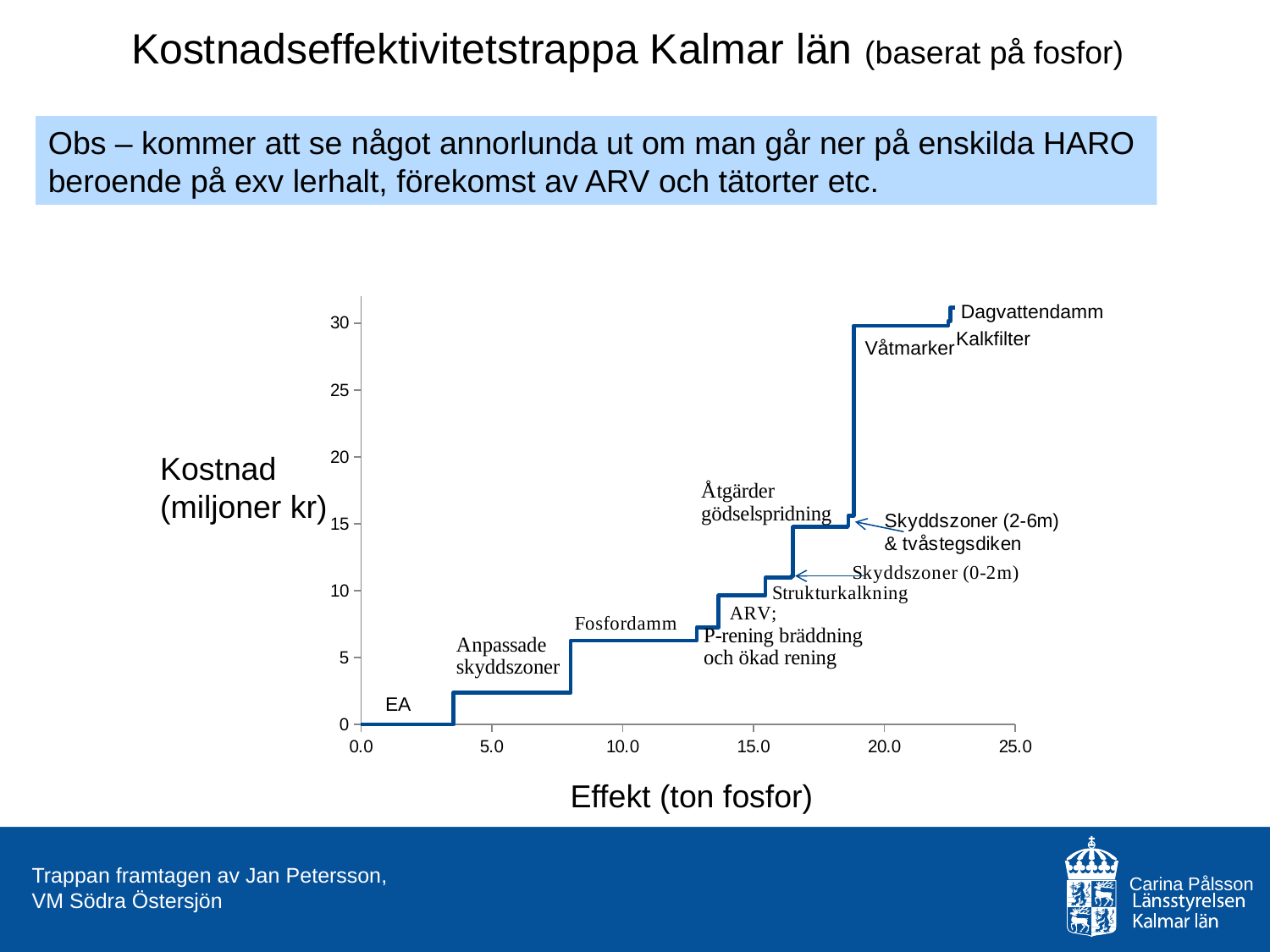
What kind of chart is shown on the slide? line chart Which has the higher cost, Åtgärder gödselspridning or Anpassade skyddszoner? Åtgärder gödselspridning Is the cost for Anpassade skyddszoner greater or less than 5? less What is the cost (miljoner kr) for EA? 0 Does the cost rise or fall as the effect increases along the x axis? rise Is the cost for Våtmarker greater or less than 25? greater What is the label of the y axis? Kostnad (miljoner kr) What is the label of the x axis? Effekt (ton fosfor) Which has the higher cost, Våtmarker or Fosfordamm? Våtmarker Which measure has the lowest cost on the chart? EA Is the cost for Fosfordamm greater or less than 10? less